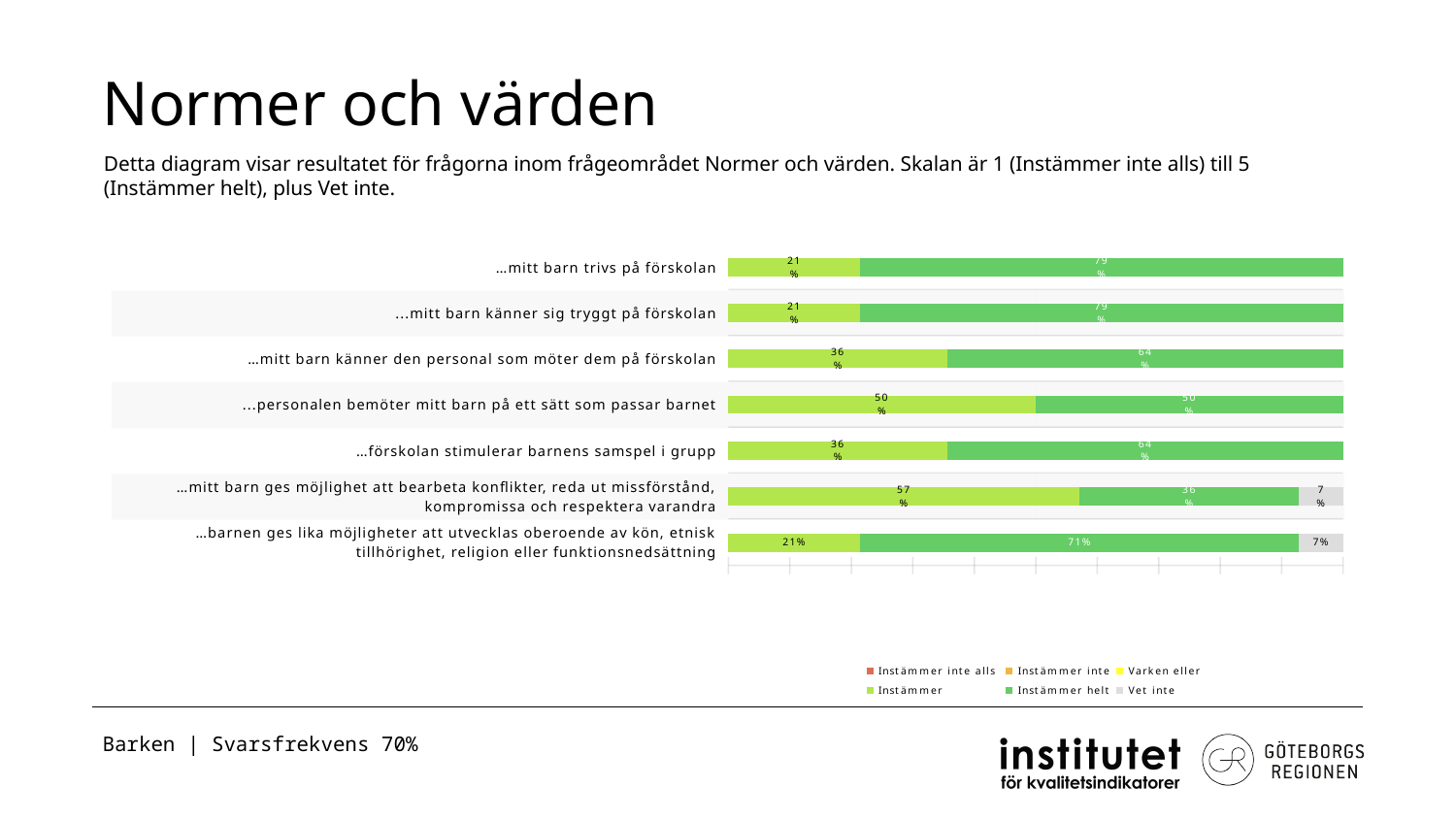
What is the difference between the 'Instämmer helt' values for '…mitt barn trivs på förskolan' and '…mitt barn känner den personal som möter dem på förskolan'? 15% What is the 'Instämmer helt' value for '…mitt barn trivs på förskolan'? 79% Which is larger: the 'Instämmer helt' value for '…förskolan stimulerar barnens samspel i grupp' or for '…personalen bemöter mitt barn på ett sätt som passar barnet'? …förskolan stimulerar barnens samspel i grupp What is the 'Vet inte' value for '…barnen ges lika möjligheter att utvecklas oberoende av kön, etnisk tillhörighet, religion eller funktionsnedsättning'? 7% How many question categories are plotted in the chart? 7 What is the total of the 'Instämmer' and 'Instämmer helt' values for '…barnen ges lika möjligheter att utvecklas oberoende av kön, etnisk tillhörighet, religion eller funktionsnedsättning'? 92% Which category has the lowest 'Instämmer helt' share? …mitt barn ges möjlighet att bearbeta konflikter, reda ut missförstånd, kompromissa och respektera varandra What is the 'Instämmer' value for '…personalen bemöter mitt barn på ett sätt som passar barnet'? 50% Which category has the highest 'Instämmer' share? …mitt barn ges möjlighet att bearbeta konflikter, reda ut missförstånd, kompromissa och respektera varandra How many series does the legend list? 6 What kind of chart is shown on the slide? stacked bar chart What is the 'Instämmer' value for '…mitt barn ges möjlighet att bearbeta konflikter, reda ut missförstånd, kompromissa och respektera varandra'? 57%